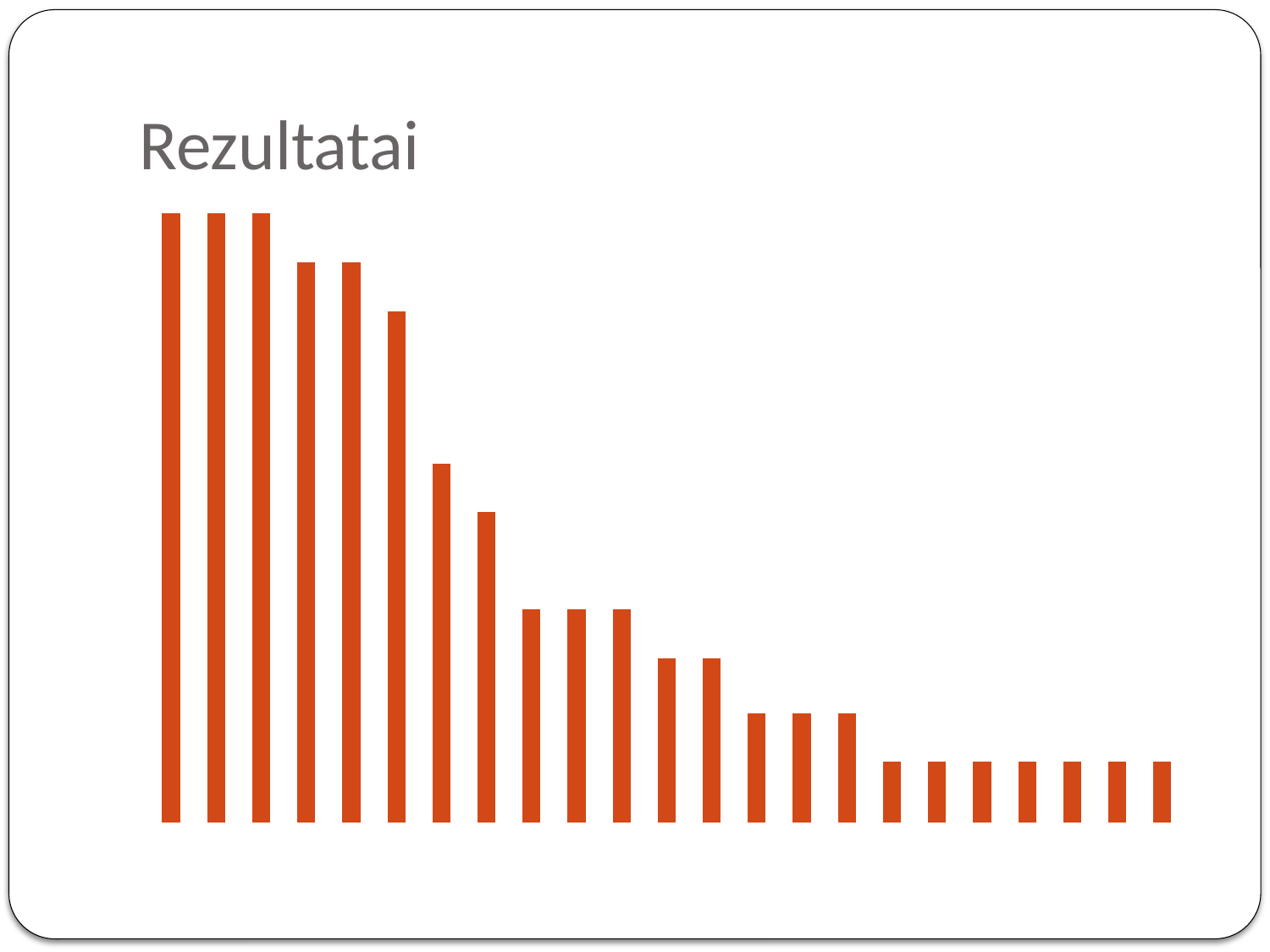
How many bars does the chart contain? 23 Do the bar values rise or fall from left to right across the chart? fall What is the title of the slide containing the chart? Rezultatai What kind of chart is shown on the slide? bar chart What colour are the bars in the chart? orange